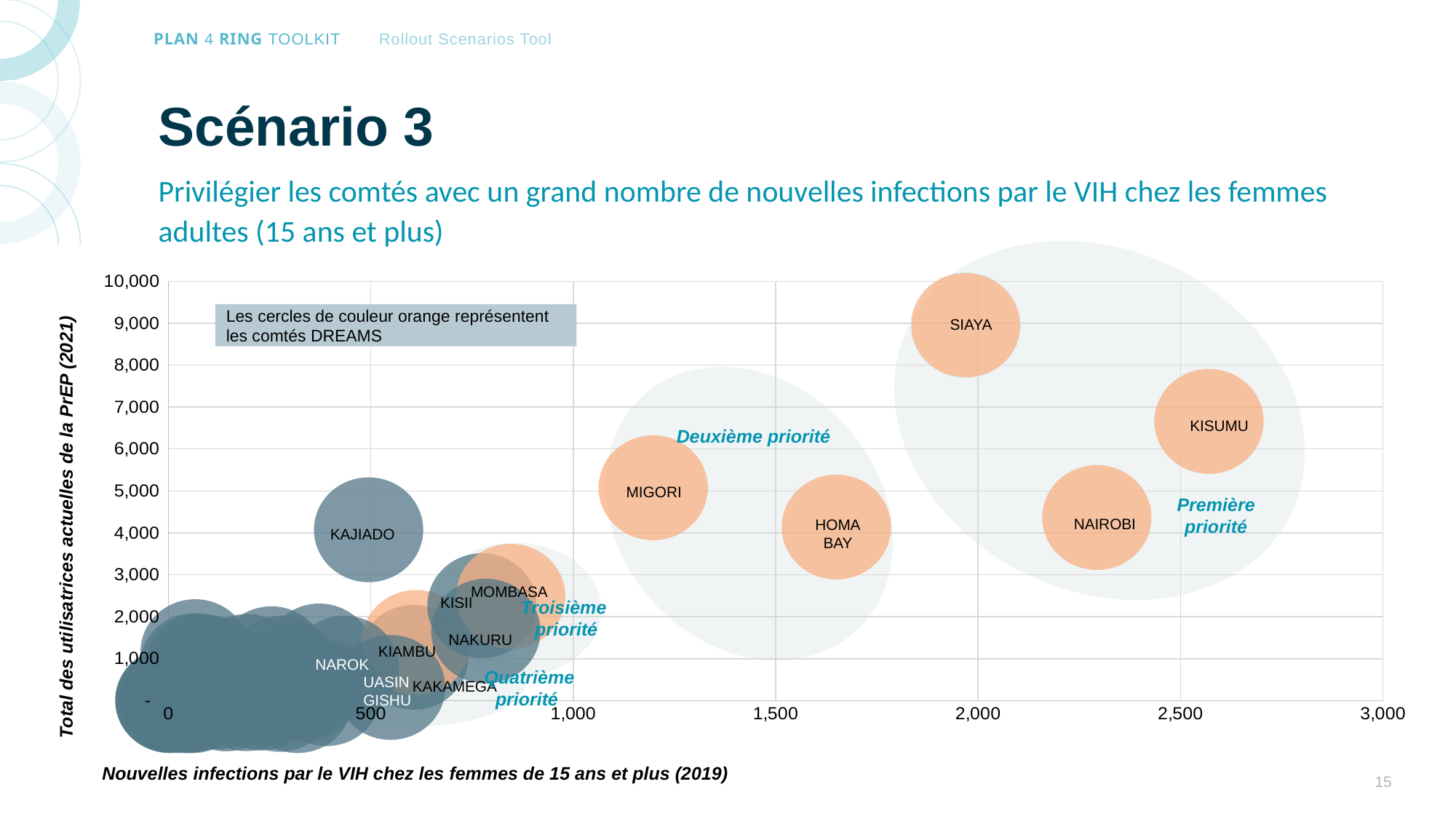
Which county has more current PrEP users, SIAYA or NAIROBI? SIAYA Is the vertical-axis value (PrEP users) for SIAYA greater or less than 8,000? greater Is the horizontal-axis value (new infections) for HOMA BAY greater or less than 1,500? greater Which county has the highest total of current PrEP users (highest position on the vertical axis)? SIAYA Is the vertical-axis value (PrEP users) for KAJIADO greater or less than 3,000? greater What kind of chart is shown on the slide? Bubble chart Which county has more new HIV infections among women 15+, MIGORI or HOMA BAY? HOMA BAY According to the note on the chart, what do the orange circles represent? Les comtés DREAMS How many priority groups are labelled on the chart? 4 Which county is furthest to the right on the horizontal axis (most new HIV infections among women 15+)? KISUMU